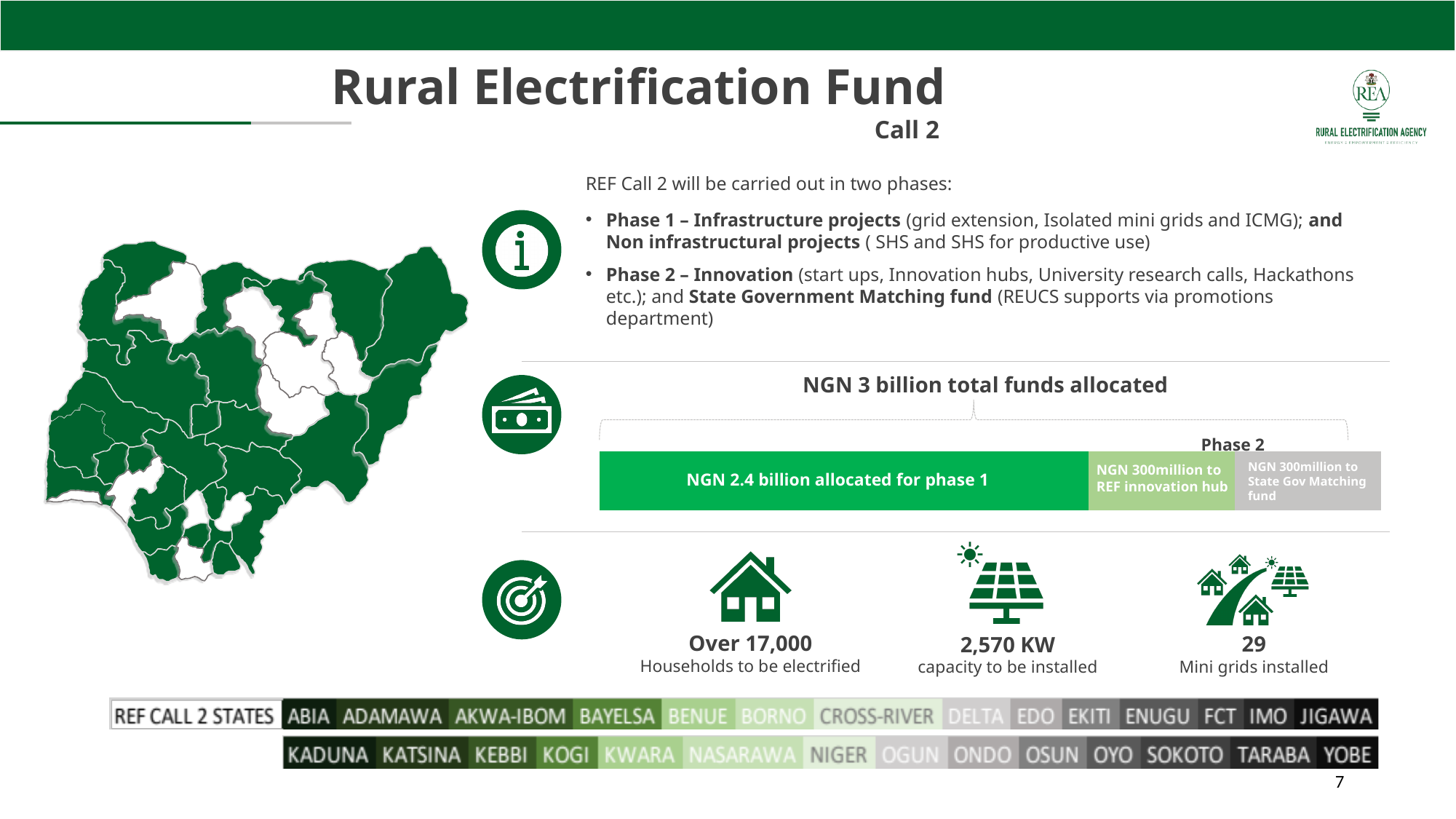
How many segments does the funds allocation bar have? 3 Which phase do the REF innovation hub and State Gov Matching fund segments belong to? Phase 2 What is the difference between the phase 1 allocation and the REF innovation hub allocation? NGN 2.1 billion In the funds allocation bar, how much is allocated for phase 1? NGN 2.4 billion In the funds allocation bar, how much is allocated to the State Gov Matching fund? NGN 300million What colour is the phase 1 segment of the funds allocation bar? Green Which is larger in the funds allocation bar: the phase 1 allocation or the REF innovation hub allocation? Phase 1 allocation What is the total of all segments in the funds allocation bar? NGN 3 billion What kind of chart shows the NGN 3 billion funds allocation? Stacked bar chart Which segment of the funds allocation bar is the largest? NGN 2.4 billion allocated for phase 1 What is the combined allocation for the two Phase 2 segments in the funds allocation bar? NGN 600 million In the funds allocation bar, how much is allocated to the REF innovation hub? NGN 300million